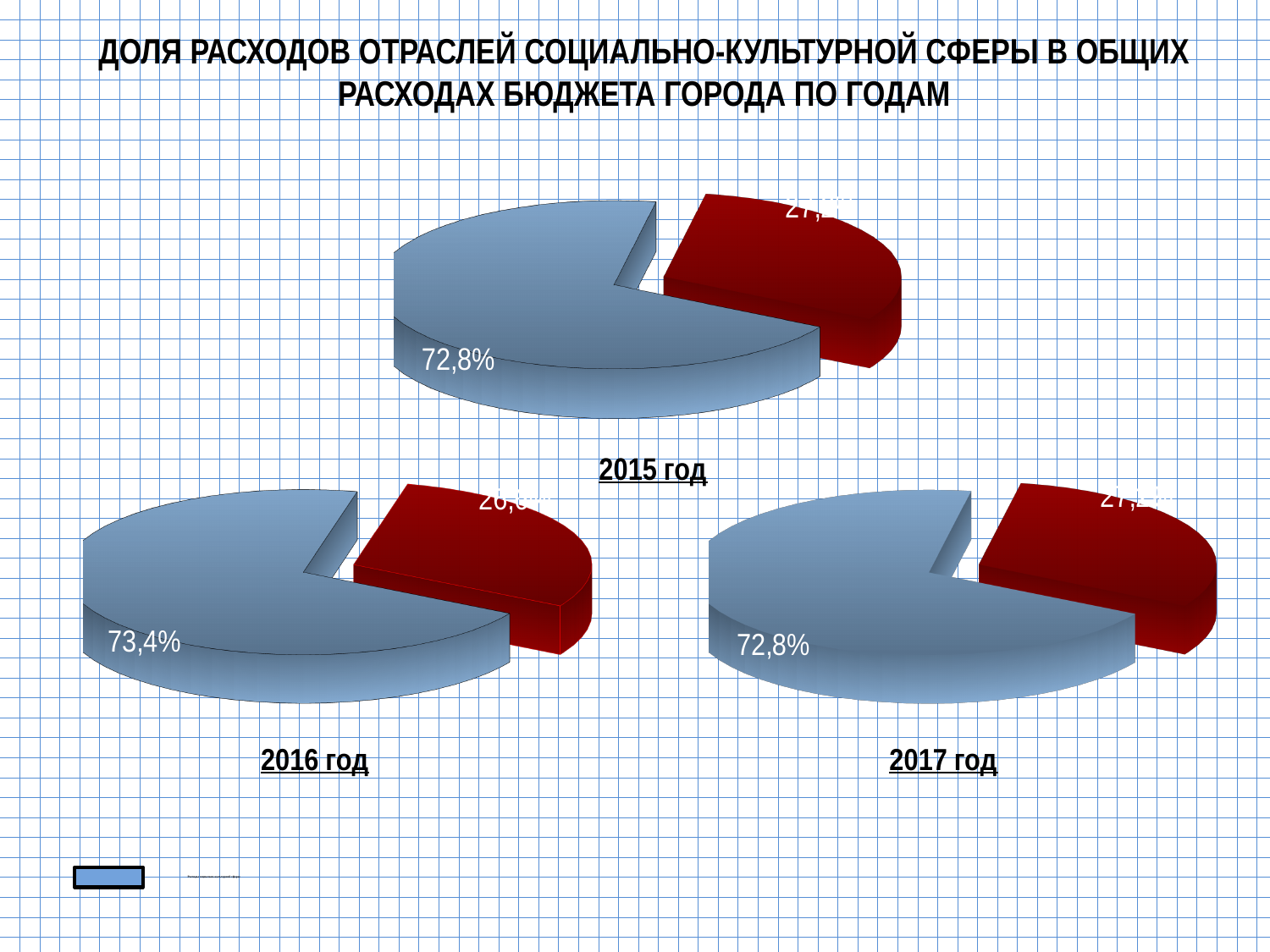
By how many percentage points does the blue slice in the 2016 год chart exceed the blue slice in the 2015 год chart? 0,6 percentage points What kind of chart is used for each year on this slide? Pie chart Which two colours are used for the slices in the pie charts? Blue and red In the 2016 год pie chart, what value is printed on the large blue slice? 73,4% Is the blue slice's share larger in the 2016 год chart or in the 2015 год chart? 2016 год In the 2015 год pie chart, what value is printed on the large blue slice? 72,8% Across the three pie charts, which year has the largest blue slice? 2016 год How many pie charts are shown on the slide? 3 In the 2017 год pie chart, what value is printed on the large blue slice? 72,8% In the 2015 год pie chart, which slice is larger, the blue one or the red one? The blue one How many slices does the 2016 год pie chart have? 2